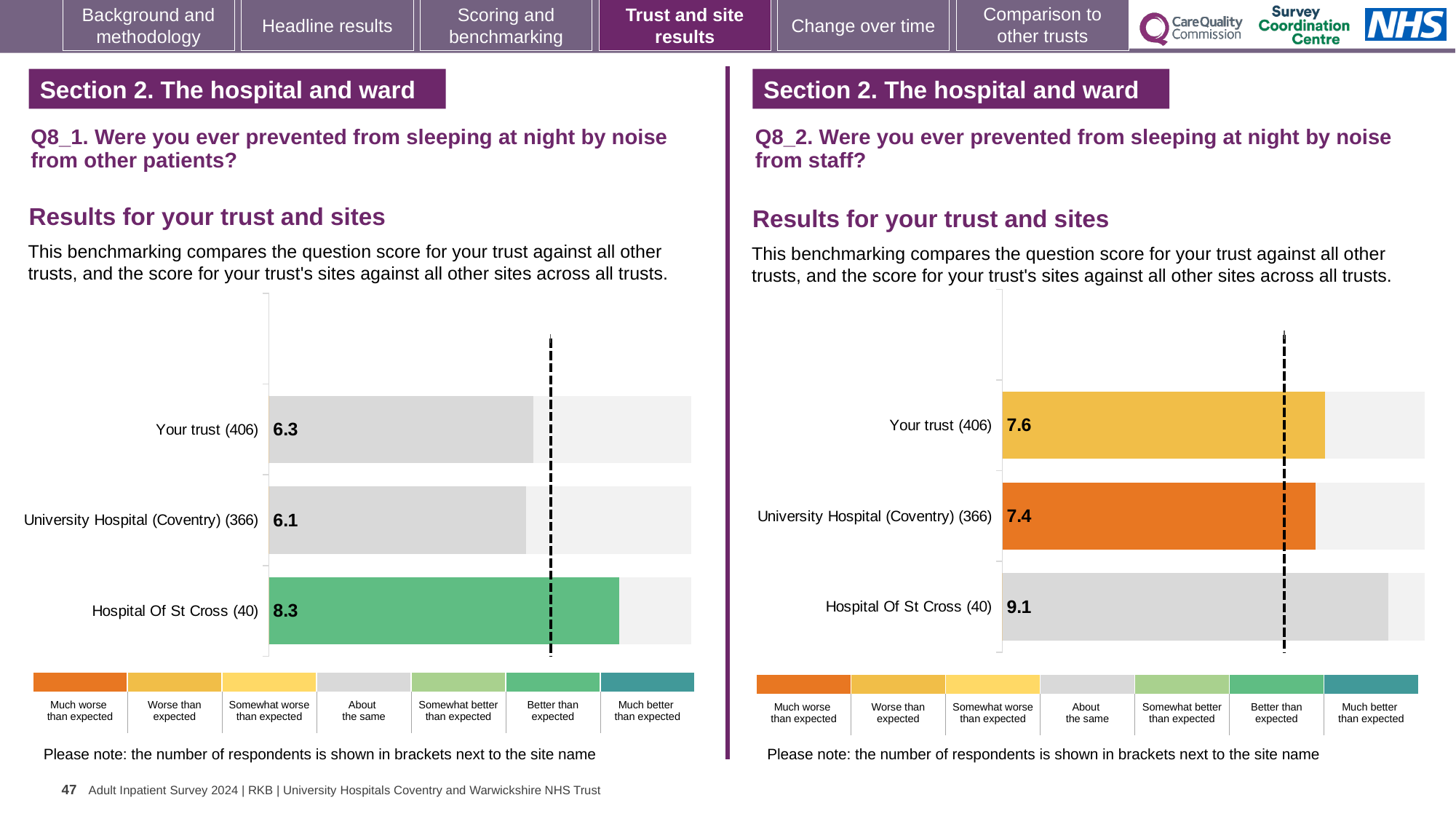
What kind of chart is used for the Q8_2 results (noise from staff)? Bar chart In the Q8_2 chart (noise from staff), which has the larger score: Your trust (406) or University Hospital (Coventry) (366)? Your trust (406) In the Q8_2 chart (noise from staff), what is the score for University Hospital (Coventry) (366)? 7.4 In the Q8_1 chart (noise from other patients), which benchmark category does the colour of the Hospital Of St Cross (40) bar correspond to in the legend? Better than expected In the Q8_2 chart (noise from staff), which site or trust has the lowest score? University Hospital (Coventry) (366) In the Q8_2 chart (noise from staff), what is the score for Your trust (406)? 7.6 In the Q8_2 chart (noise from staff), what is the difference between the scores for Hospital Of St Cross (40) and Your trust (406)? 1.5 How many bars are plotted in the Q8_1 chart (noise from other patients)? 3 In the Q8_1 chart (noise from other patients), what is the score for Your trust (406)? 6.3 In the Q8_1 chart (noise from other patients), what is the difference between the scores for Hospital Of St Cross (40) and University Hospital (Coventry) (366)? 2.2 In the Q8_1 chart (noise from other patients), what is the score for Hospital Of St Cross (40)? 8.3 In the Q8_1 chart (noise from other patients), which site or trust has the highest score? Hospital Of St Cross (40)